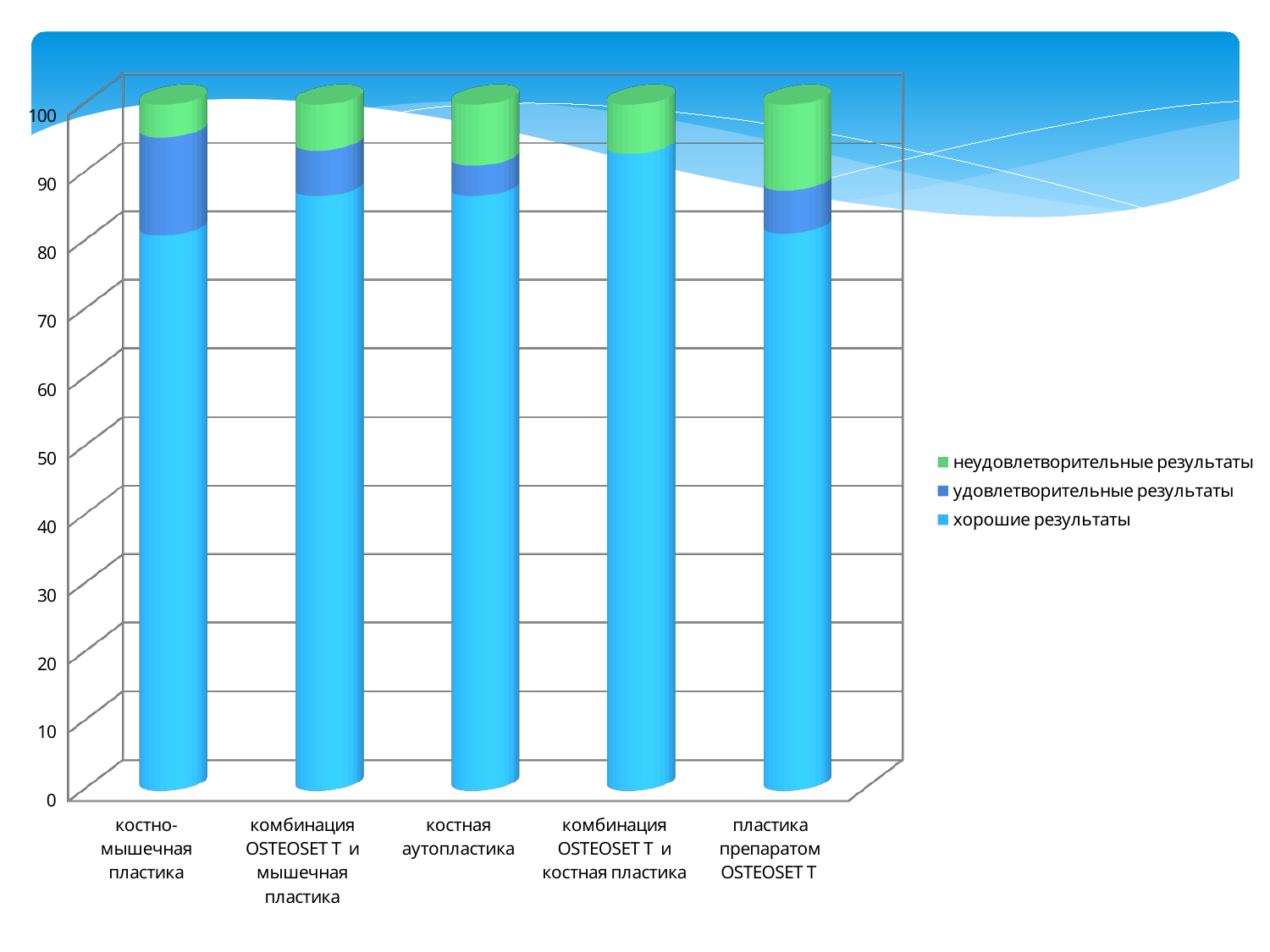
Which category has the highest value for хорошие результаты? комбинация OSTEOSET T и костная пластика What kind of chart is shown on the slide? stacked bar chart How many categories are shown along the x axis? 5 Is the value for хорошие результаты in пластика препаратом OSTEOSET T greater or less than 70? greater Which category has the largest segment for неудовлетворительные результаты? пластика препаратом OSTEOSET T Is the value for хорошие результаты in костно-мышечная пластика greater or less than 90? less Is the value for хорошие результаты in комбинация OSTEOSET T и костная пластика greater or less than 90? greater How many series does the legend list? 3 Which category has the smallest segment for удовлетворительные результаты? комбинация OSTEOSET T и костная пластика Which is larger: the удовлетворительные результаты segment for костно-мышечная пластика or for костная аутопластика? костно-мышечная пластика Which series is shown in green in the legend? неудовлетворительные результаты What is the total height of the stacked bar for костно-мышечная пластика? 100